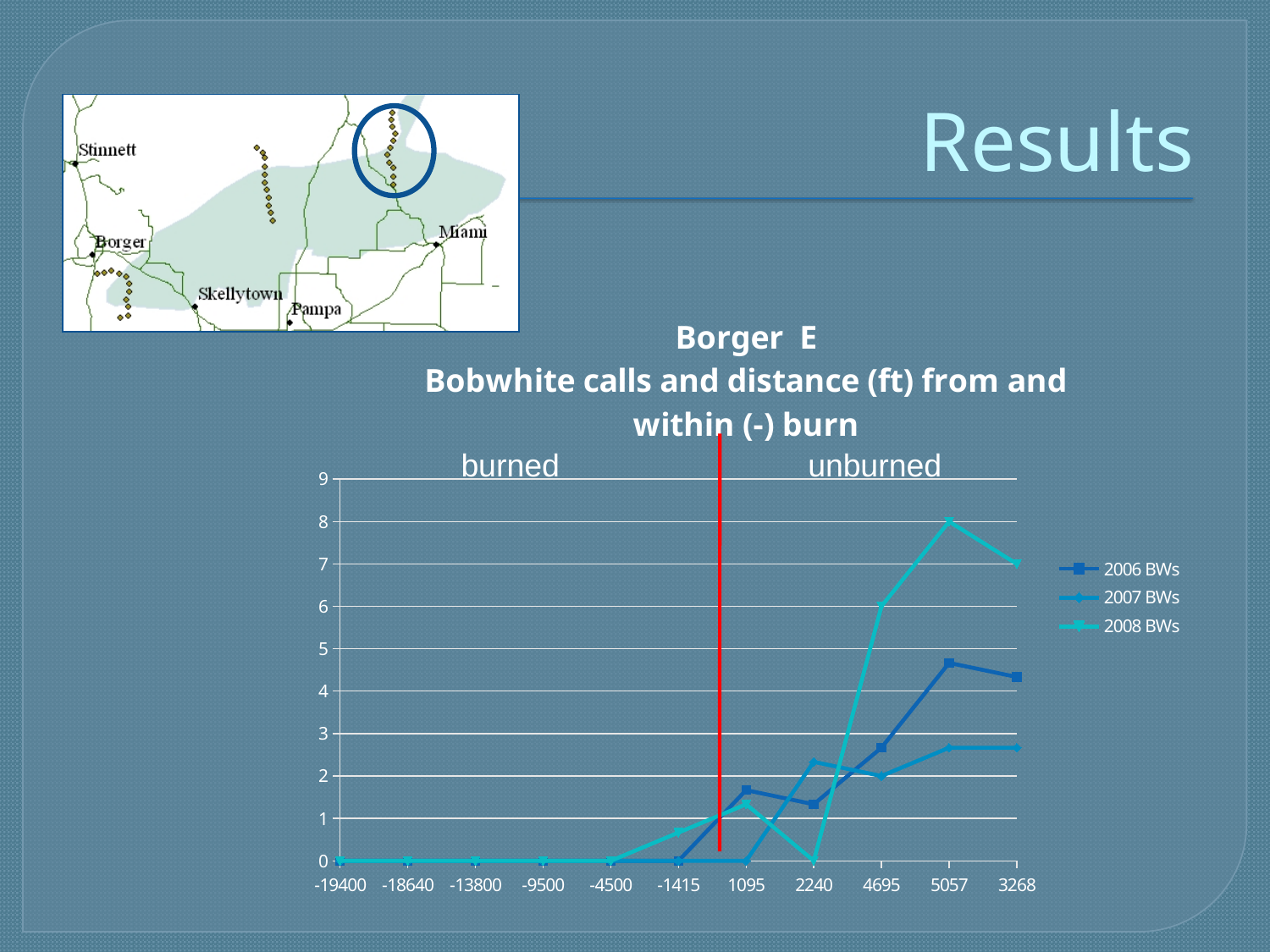
How many series does the legend list? 3 What are the two region labels written above the plot area? burned and unburned Which series has the highest value at 5057? 2008 BWs How many distance categories are shown on the x axis? 11 What is the value for 2007 BWs at 1095? 0 At 4695, which is larger: 2006 BWs or 2007 BWs? 2006 BWs What type of chart is shown on the slide? line chart What is the value for 2008 BWs at 2240? 0 What is the value for 2006 BWs at -19400? 0 Is the value for 2006 BWs at 3268 greater or less than 5? less Is the value for 2007 BWs at 3268 greater or less than 3? less Is the value for 2008 BWs at 5057 greater or less than 7? greater